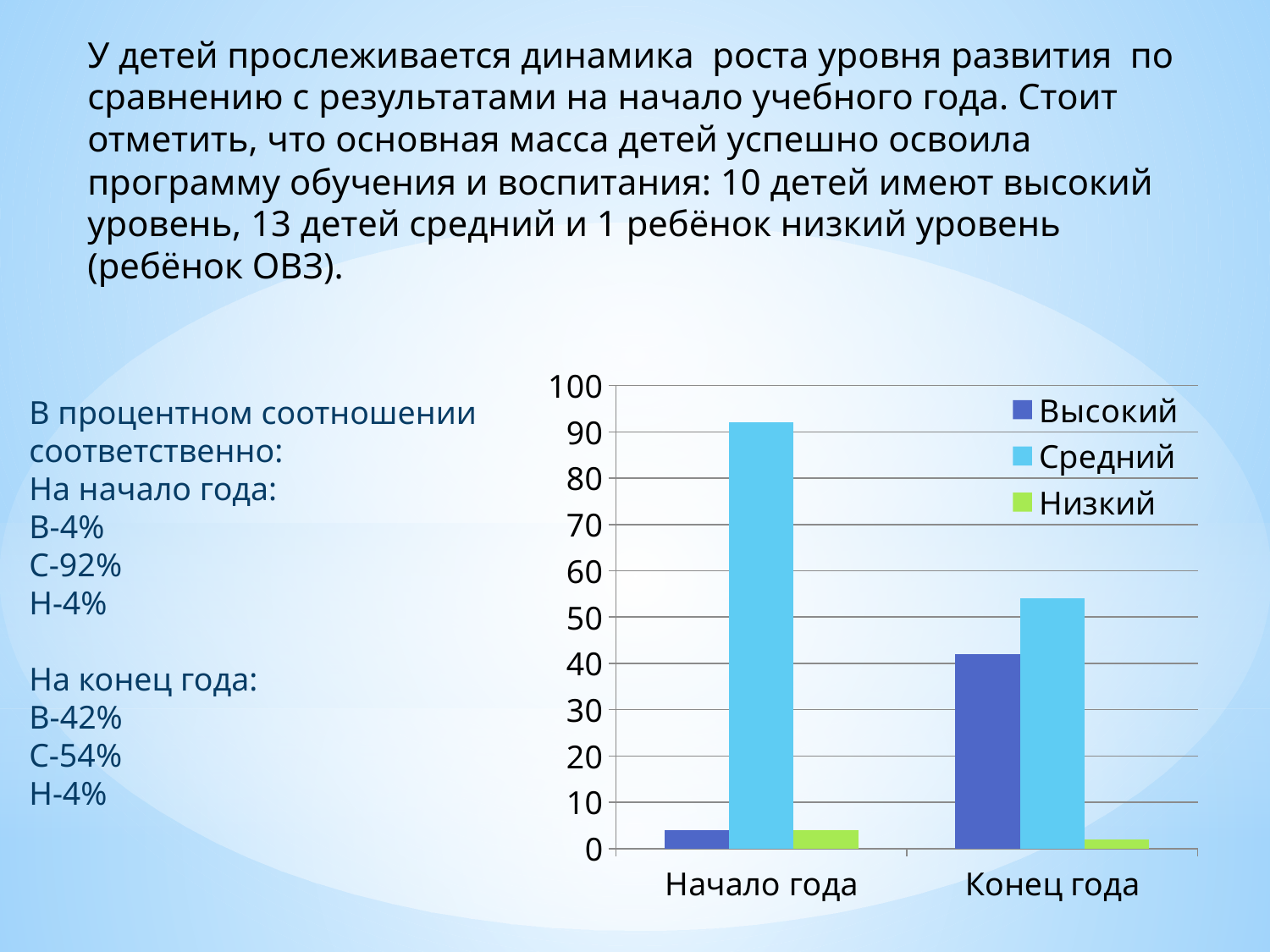
Does the Средний series rise or fall from Начало года to Конец года? fall What colour are the bars for the Низкий series? green Is the value for Средний at Конец года greater or less than 60? less Which is larger: Высокий at Конец года or Высокий at Начало года? Высокий at Конец года Which series has the lowest bar for Конец года? Низкий How many series does the chart legend list? 3 Is the value for Высокий at Конец года greater or less than 40? greater Is the value for Средний at Начало года greater or less than 90? greater How many categories are shown on the x axis of the chart? 2 What kind of chart is shown on the slide? bar chart Which series has the highest bar for Начало года? Средний